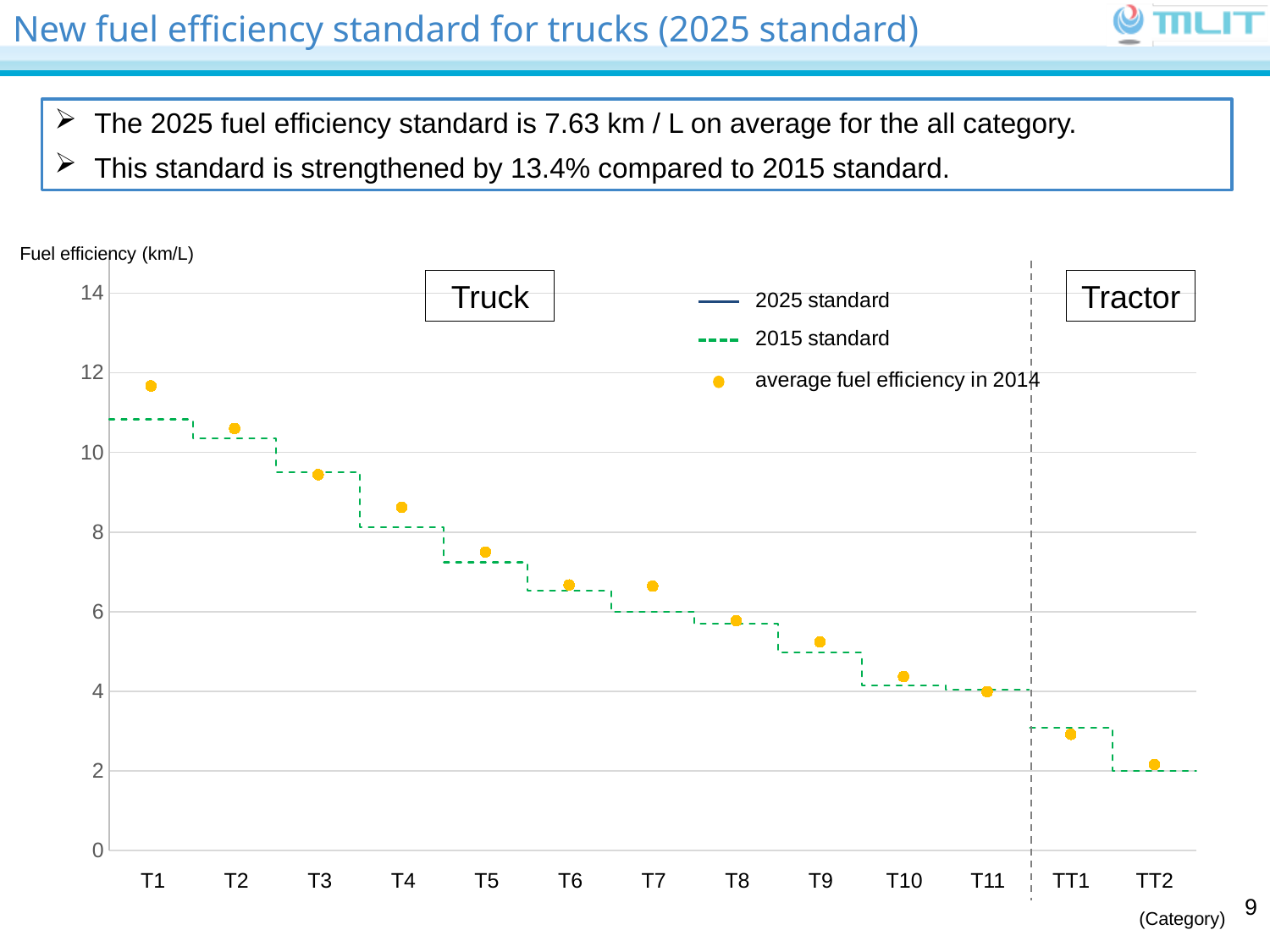
Is the average fuel efficiency in 2014 for T4 greater or less than 8? greater Is the average fuel efficiency in 2014 for TT1 greater or less than 4? less Is the average fuel efficiency in 2014 for T8 greater or less than 6? less Which legend entry is drawn as a dashed line? 2015 standard How many series does the chart's legend list? 3 What is the label of the vertical axis of the chart? Fuel efficiency (km/L) Which has the higher average fuel efficiency in 2014, T3 or T7? T3 Which category has the highest average fuel efficiency in 2014? T1 Do the average fuel efficiency in 2014 values rise or fall from T1 to TT2 along the x axis? fall Which category has the lowest average fuel efficiency in 2014? TT2 How many categories are shown on the x axis of the chart? 13